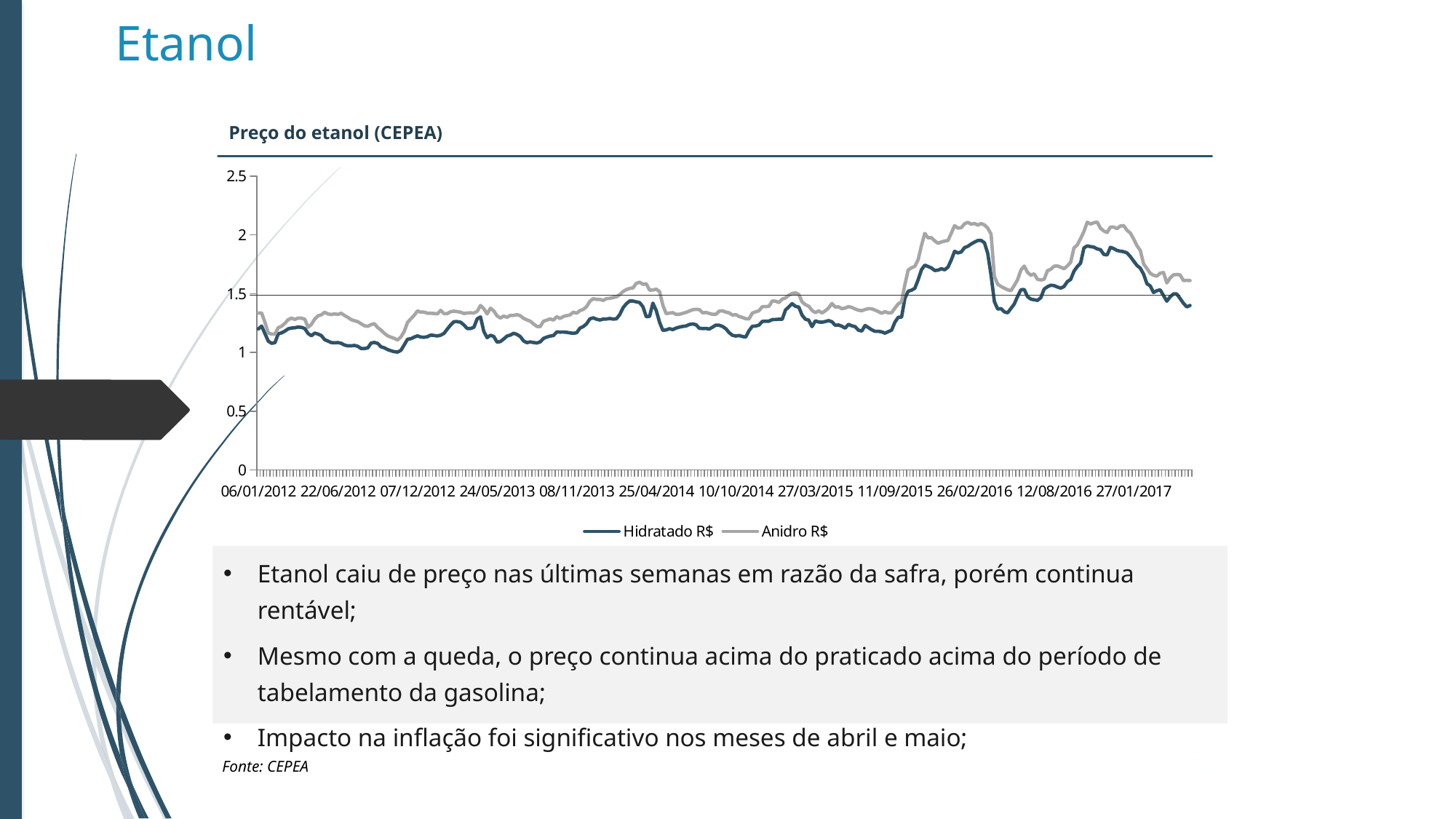
Is the value of Hidratado R$ at the end of the series (after 27/01/2017) greater or less than 1.5? less What kind of chart is shown on the slide? line chart Is the peak value of Anidro R$ around 26/02/2016 greater or less than 2? greater How many series does the legend of the chart list? 2 Is the value of Hidratado R$ at 06/01/2012 greater or less than 1.5? less Which series is higher around 26/02/2016, Hidratado R$ or Anidro R$? Anidro R$ Which two series are listed in the chart legend? Hidratado R$ and Anidro R$ Do the ethanol prices rise or fall between 11/09/2015 and 26/02/2016? rise What is the title of the chart? Preço do etanol (CEPEA) Which series generally runs above the other throughout the chart? Anidro R$